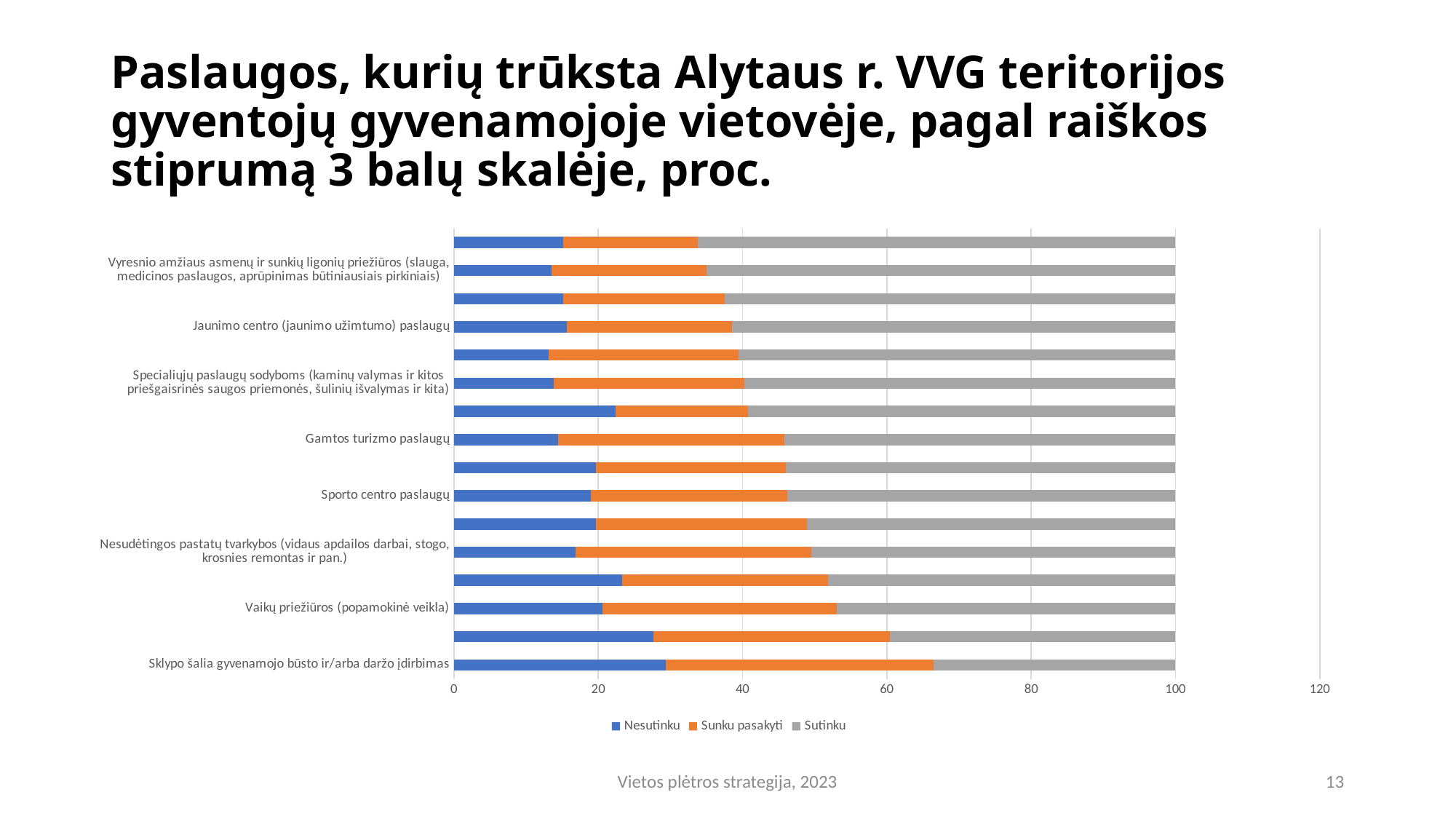
Is the 'Sutinku' value for 'Sklypo šalia gyvenamojo būsto ir/arba daržo įdirbimas' greater or less than 40? less Is the 'Nesutinku' value for 'Sklypo šalia gyvenamojo būsto ir/arba daržo įdirbimas' greater or less than 20? greater How many series does the legend list? 3 Among the labelled categories, which has the largest 'Nesutinku' value? Sklypo šalia gyvenamojo būsto ir/arba daržo įdirbimas How many bars are plotted in the chart? 16 Is the 'Nesutinku' value for 'Vyresnio amžiaus asmenų ir sunkių ligonių priežiūros' greater or less than 20? less What are the three series named in the legend? Nesutinku, Sunku pasakyti, Sutinku What is the highest value shown on the horizontal axis? 120 What is the total of the stacked bar for 'Sklypo šalia gyvenamojo būsto ir/arba daržo įdirbimas'? 100 Which has the larger 'Nesutinku' value: 'Sklypo šalia gyvenamojo būsto ir/arba daržo įdirbimas' or 'Gamtos turizmo paslaugų'? Sklypo šalia gyvenamojo būsto ir/arba daržo įdirbimas What kind of chart is shown on the slide? Stacked bar chart